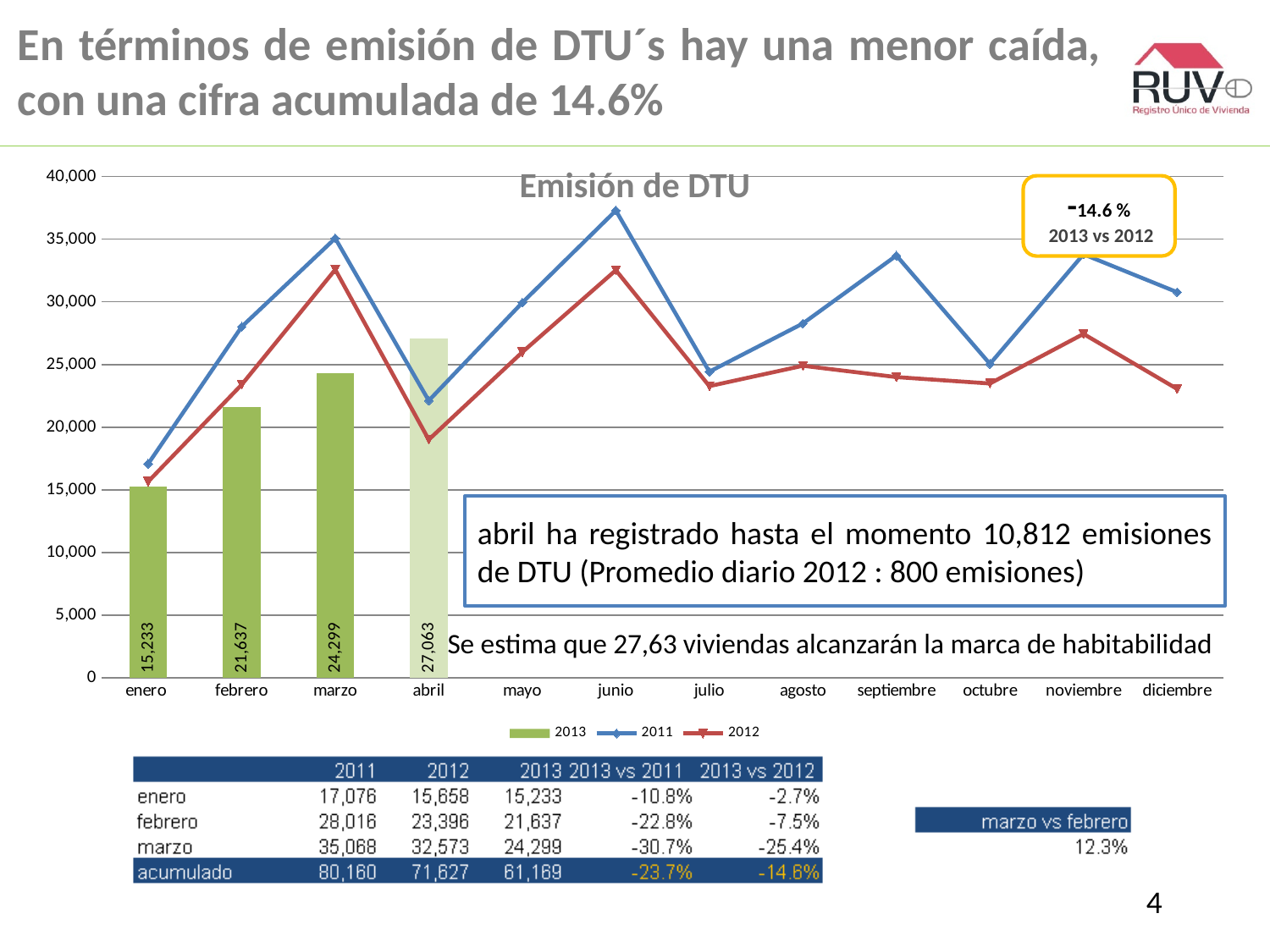
What is the value of the 2013 bar for enero in the Emisión de DTU chart? 15,233 Which month has the lowest 2013 bar in the Emisión de DTU chart? enero What kind of chart is the Emisión de DTU chart? Combined bar and line chart In junio, which series is higher in the Emisión de DTU chart, 2011 or 2012? 2011 How many series does the legend of the Emisión de DTU chart list? 3 Do the 2013 bars rise or fall from enero to abril in the Emisión de DTU chart? rise Which month has the highest 2013 bar in the Emisión de DTU chart? abril Is the 2012 value for diciembre in the Emisión de DTU chart greater or less than 25,000? less What is the value of the 2013 bar for marzo in the Emisión de DTU chart? 24,299 What is the value of the 2013 bar for abril in the Emisión de DTU chart? 27,063 What is the difference between the 2013 values for febrero and enero in the Emisión de DTU chart? 6,404 Is the 2011 value for junio in the Emisión de DTU chart greater or less than 35,000? greater